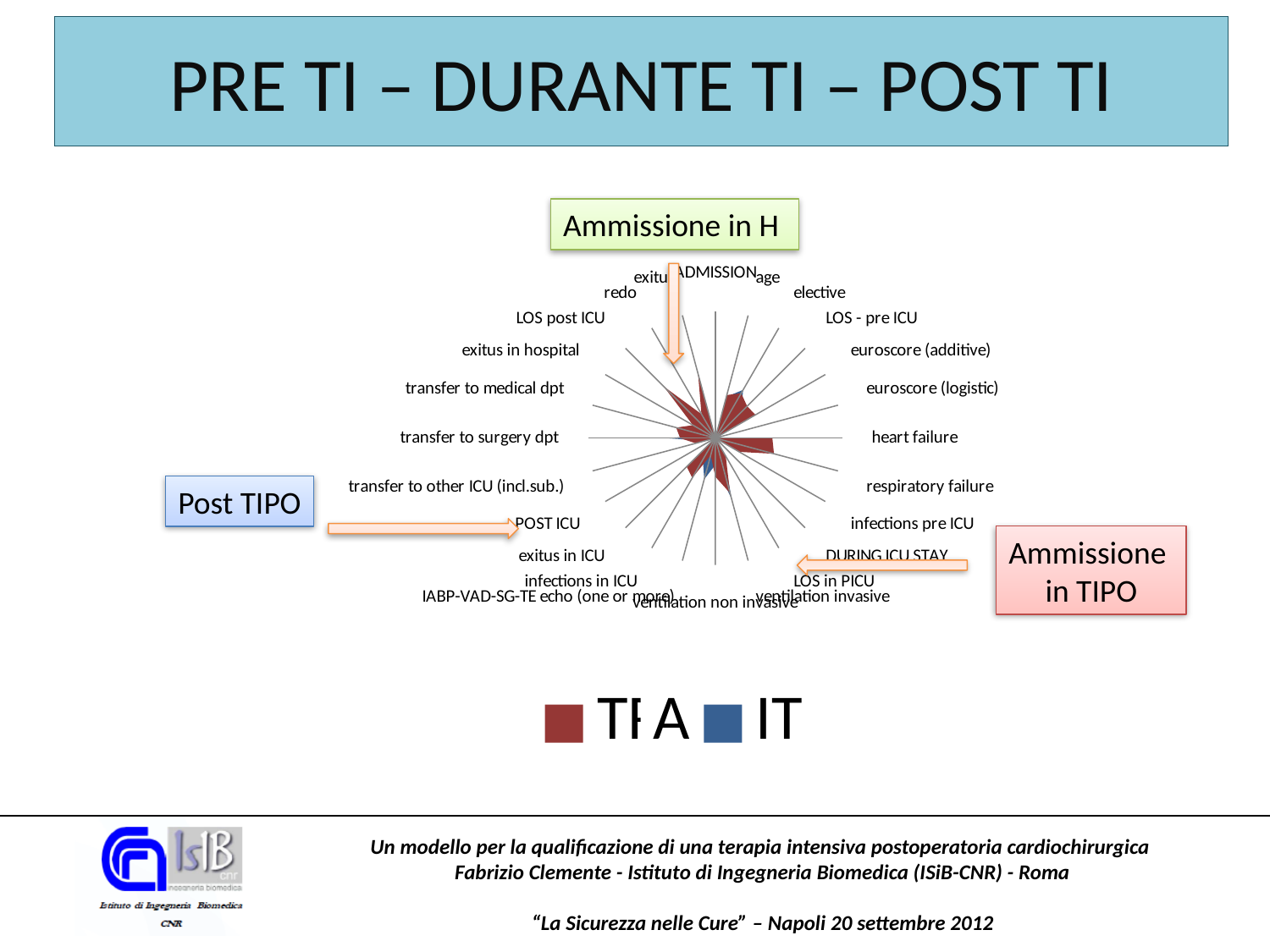
How many series does the chart legend list? 2 For the heart failure axis, is the red series or the blue series larger? red What colour is used for the IT series in the chart legend? blue What kind of chart is shown on the slide? radar chart